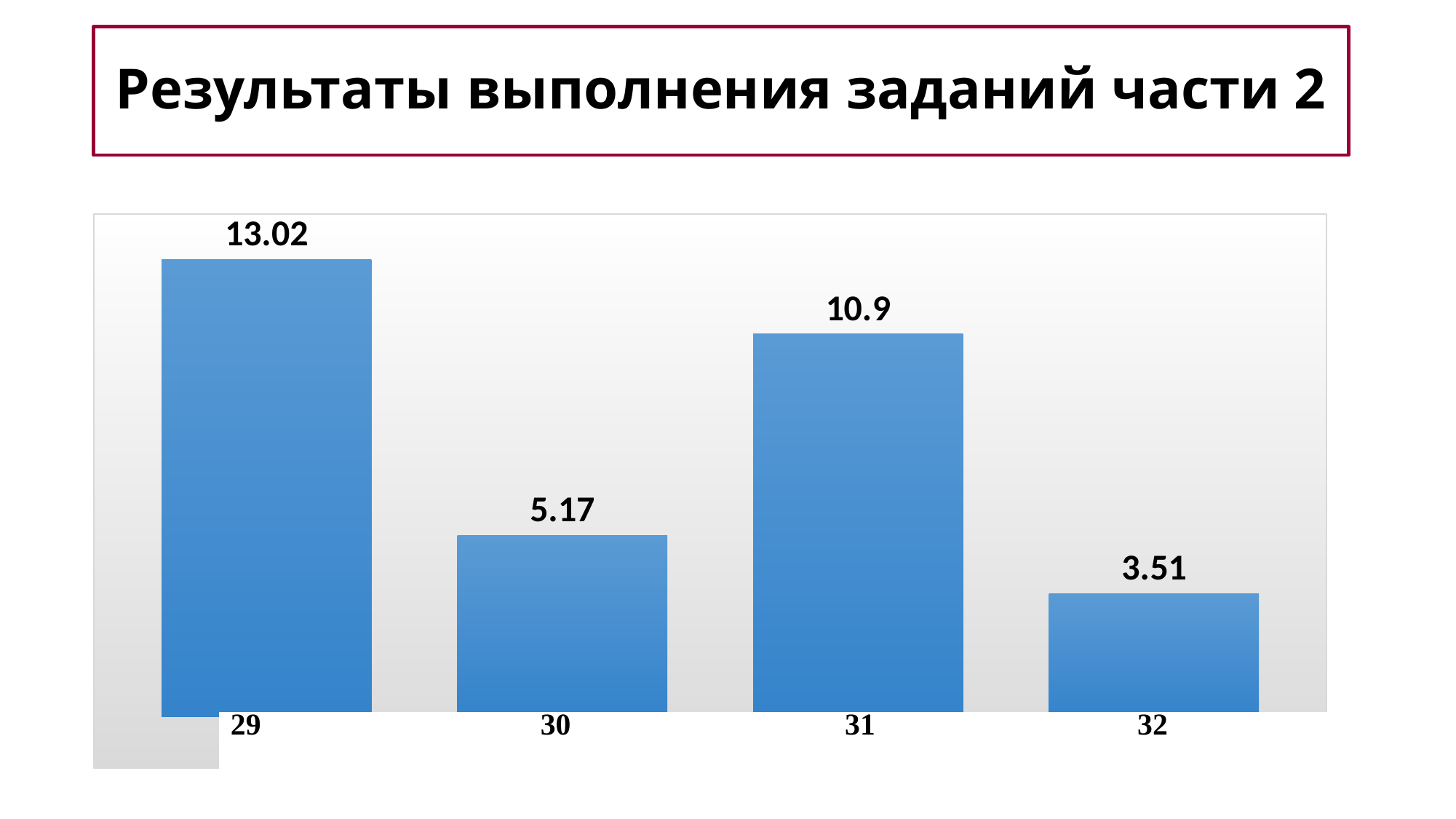
Which category has the highest value? 29 What is the title of the slide? Результаты выполнения заданий части 2 What kind of chart is shown on the slide? bar chart How many categories are shown in the chart? 4 What is the value for category 31? 10.9 Which category has the lowest value? 32 What is the value for category 29? 13.02 What is the difference between the values for 29 and 31? 2.12 What is the value for category 30? 5.17 What is the value for category 32? 3.51 Which is larger, the value for 30 or the value for 31? 31 What is the difference between the values for 30 and 32? 1.66